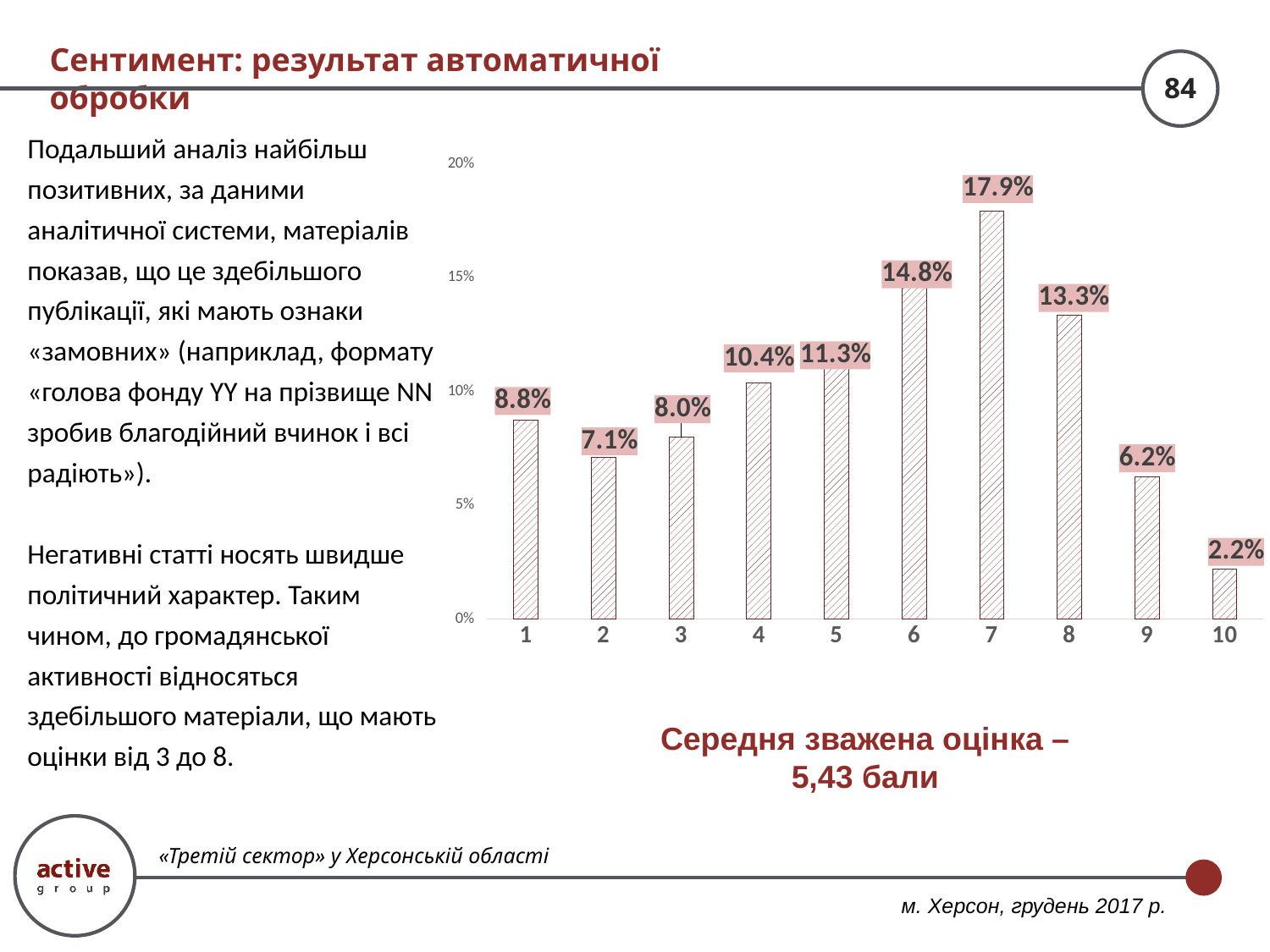
Which category has the highest value? 7 How many categories are shown on the x axis? 10 What is the value for category 10? 2.2% Is the value for category 6 greater or less than 10%? greater What kind of chart is shown on the slide? bar chart What is the difference between the values for category 2 and category 3? 0.9% What is the difference between the values for category 7 and category 8? 4.6% Which category has the lowest value? 10 Which is larger, the value for category 4 or the value for category 5? 5 What is the value for category 7? 17.9% What is the value for category 1? 8.8% Do the values rise or fall from category 7 to category 10? fall